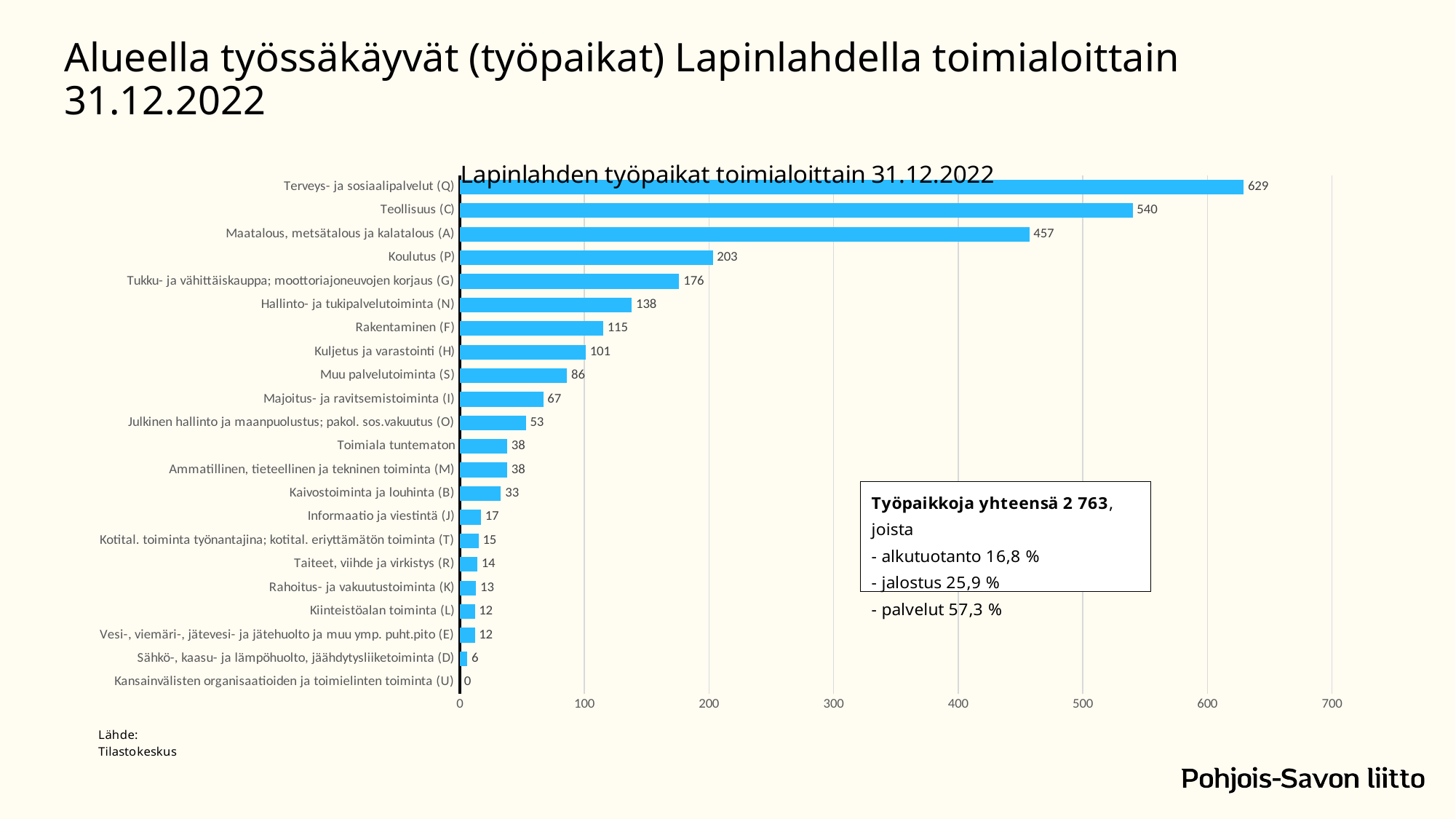
What is the difference between Teollisuus (C) and Maatalous, metsätalous ja kalatalous (A)? 83 Which category has the highest value? Terveys- ja sosiaalipalvelut (Q) What is the value for Terveys- ja sosiaalipalvelut (Q)? 629 Which is larger, Hallinto- ja tukipalvelutoiminta (N) or Kuljetus ja varastointi (H)? Hallinto- ja tukipalvelutoiminta (N) What is the title of the chart? Lapinlahden työpaikat toimialoittain 31.12.2022 What is the value for Koulutus (P)? 203 Which category has the lowest value? Kansainvälisten organisaatioiden ja toimielinten toiminta (U) What is the value for Rakentaminen (F)? 115 Is the value for Tukku- ja vähittäiskauppa; moottoriajoneuvojen korjaus (G) greater or less than 200? less What kind of chart is shown on the slide? Bar chart How many categories are shown in the chart? 22 What is the value for Sähkö-, kaasu- ja lämpöhuolto, jäähdytysliiketoiminta (D)? 6